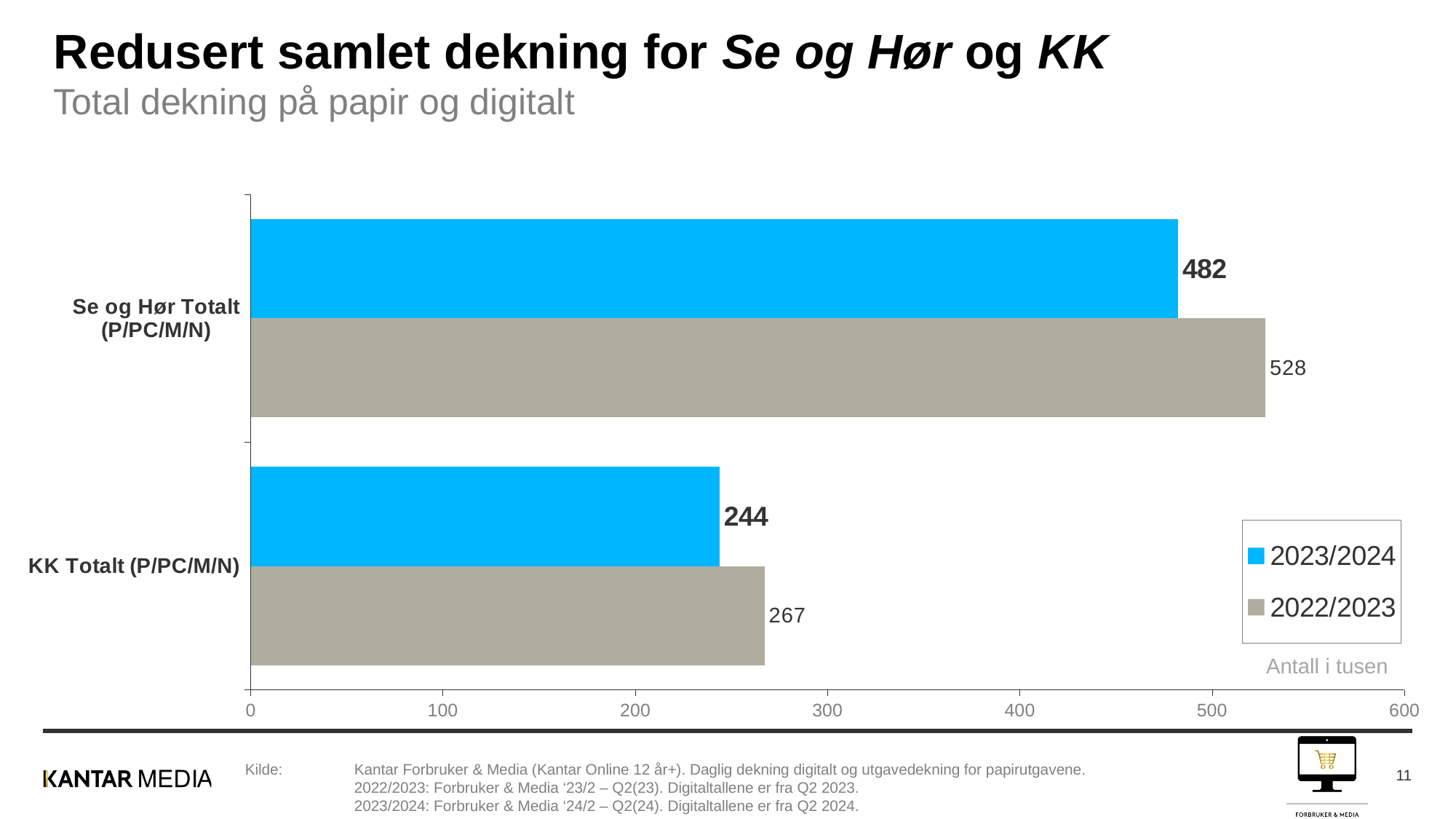
What kind of chart is shown on the slide? Bar chart What is the difference between the 2022/2023 and 2023/2024 values for KK Totalt (P/PC/M/N)? 23 How many series does the legend list? 2 Which category has the highest value in the 2022/2023 series? Se og Hør Totalt (P/PC/M/N) What unit note is shown below the legend? Antall i tusen What is the difference between the 2022/2023 and 2023/2024 values for Se og Hør Totalt (P/PC/M/N)? 46 For KK Totalt (P/PC/M/N), which series has the larger value, 2023/2024 or 2022/2023? 2022/2023 What is the value for Se og Hør Totalt (P/PC/M/N) in 2022/2023? 528 What is the value for Se og Hør Totalt (P/PC/M/N) in 2023/2024? 482 What is the value for KK Totalt (P/PC/M/N) in 2022/2023? 267 What is the value for KK Totalt (P/PC/M/N) in 2023/2024? 244 Which category has the lowest value in the 2023/2024 series? KK Totalt (P/PC/M/N)